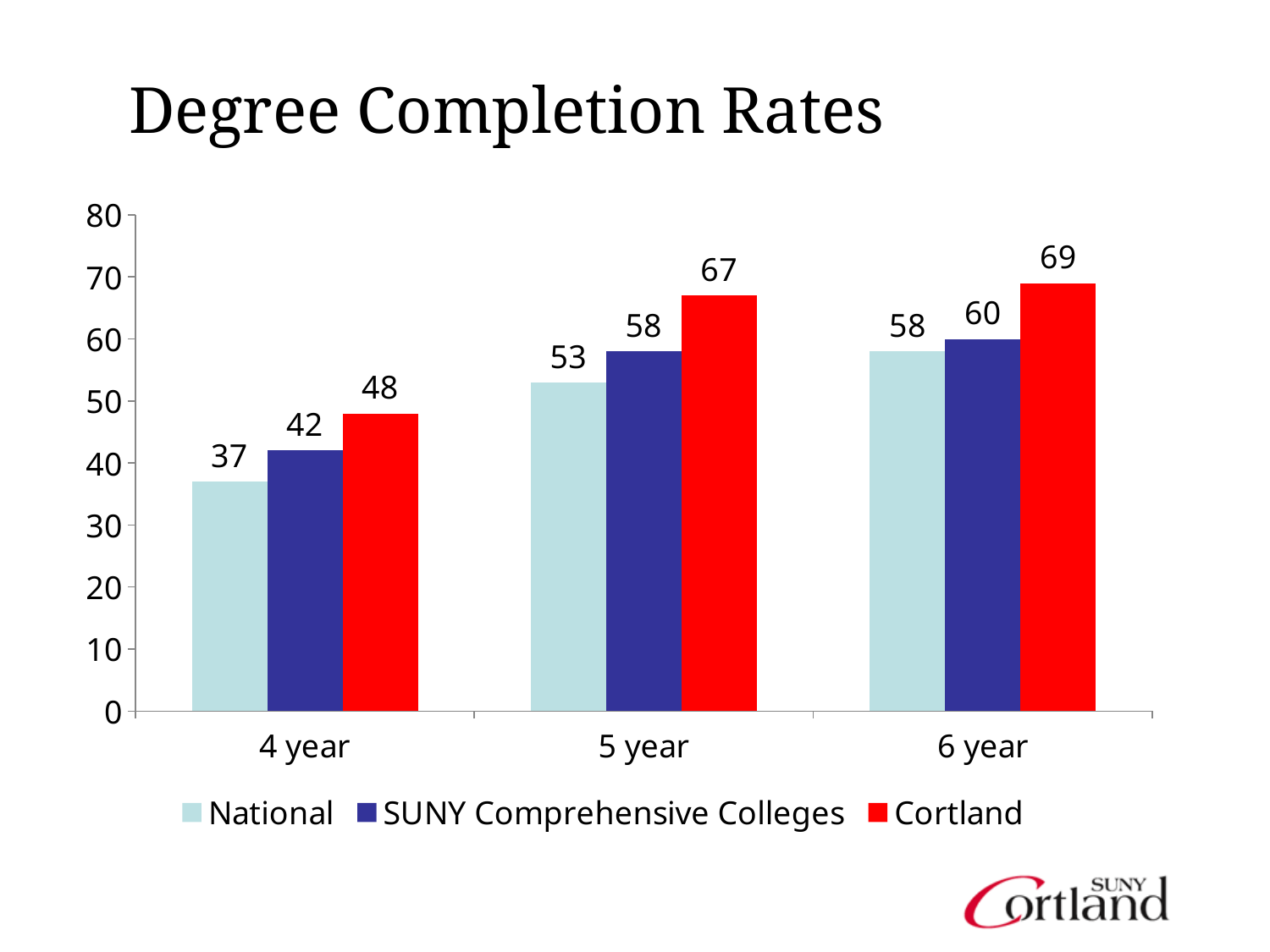
Which category has the highest Cortland value? 6 year How many categories are shown on the x axis? 3 What is the National degree completion rate at 6 year? 58 What is the SUNY Comprehensive Colleges value at 5 year? 58 Which category has the lowest National value? 4 year How many series does the legend list? 3 What is the Cortland degree completion rate at 4 year? 48 Which is larger at 6 year, the Cortland value or the SUNY Comprehensive Colleges value? Cortland What is the difference between the SUNY Comprehensive Colleges and National values at 4 year? 5 What kind of chart is shown on the slide? Bar chart What is the difference between the Cortland and National values at 5 year? 14 Do the Cortland values rise or fall from 4 year to 6 year? Rise